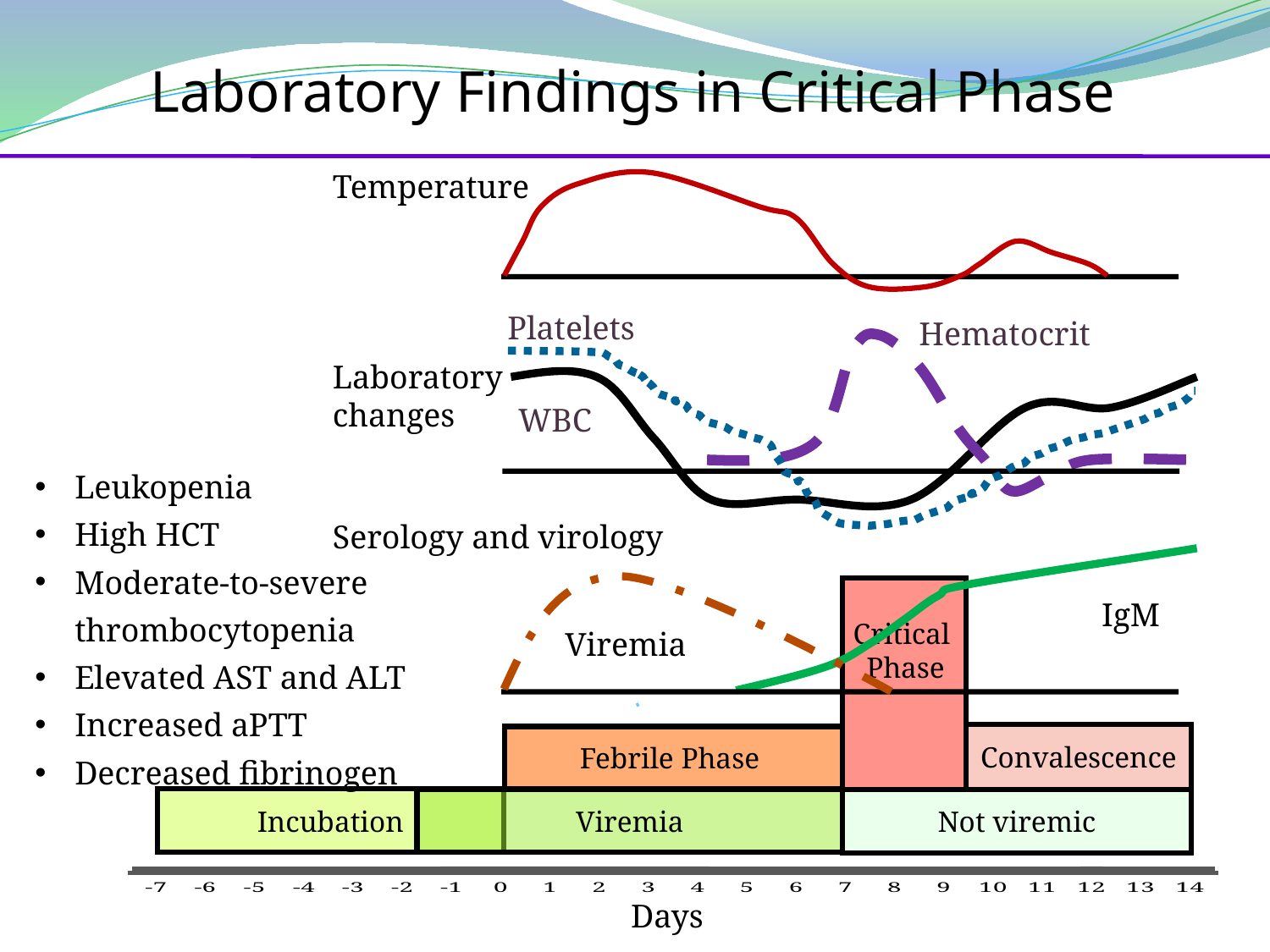
Does the IgM curve rise or fall as days increase? Rises What is the label on the x axis of the chart? Days Which phase is shown in the red box between the Febrile Phase and Convalescence? Critical Phase What is the highest day value shown on the x axis? 14 How many phases are labeled in the upper row of phase boxes (Febrile Phase, Critical Phase, Convalescence)? 3 Is the WBC curve above or below its baseline at day 5? Below What is the lowest day value shown on the x axis? -7 At which day does the Critical Phase begin on the x axis? 7 Which curve is drawn as a dotted blue line in the Laboratory changes panel? Platelets At which day does the Febrile Phase begin on the x axis? 0 Does the Temperature curve rise or fall between day 3 and day 7? Falls Which laboratory curve peaks during the Critical Phase? Hematocrit